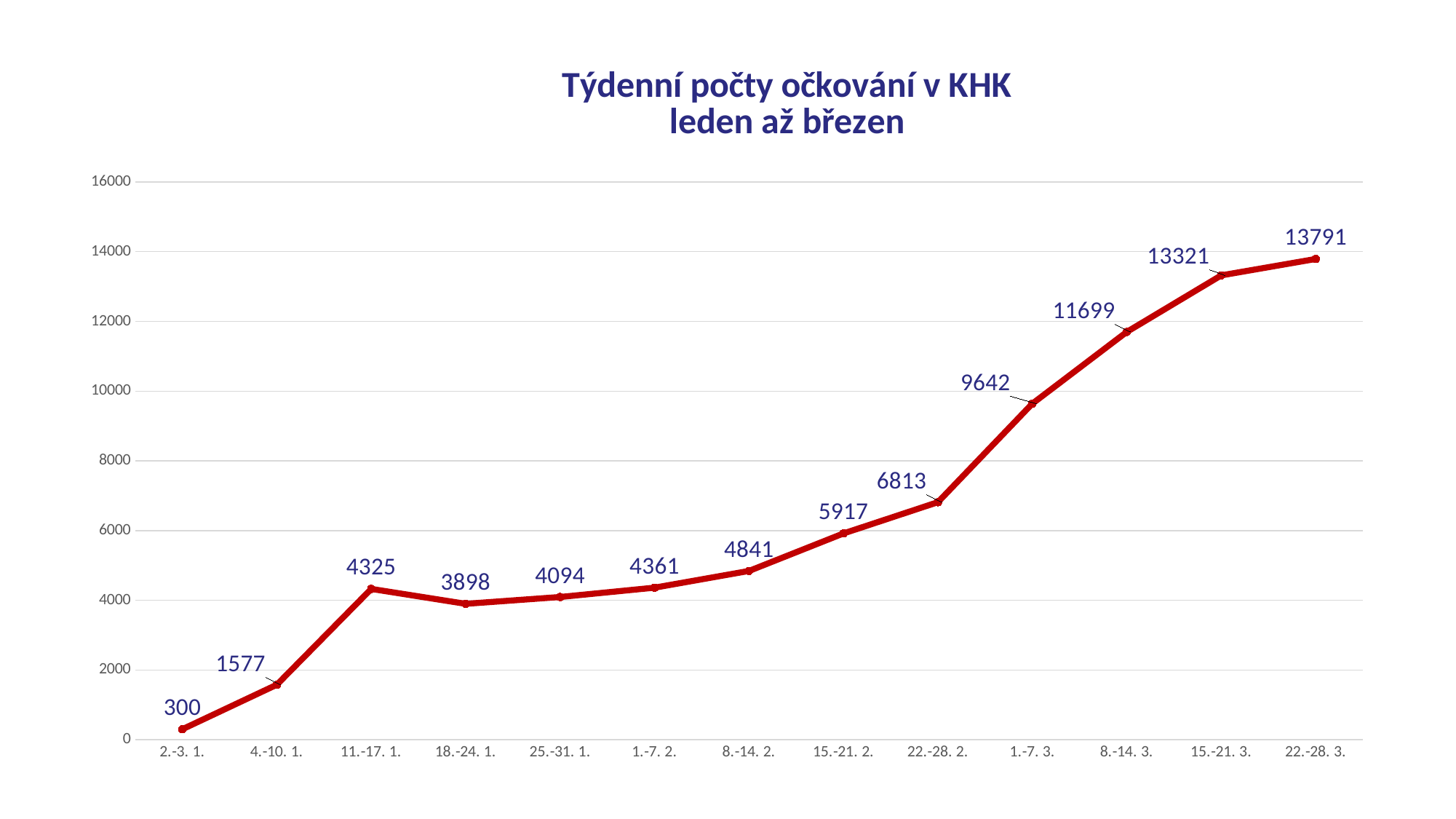
What is the title of the chart? Týdenní počty očkování v KHK leden až březen Which week has the highest value? 22.-28. 3. Which is larger, the value for 11.-17. 1. or the value for 25.-31. 1.? 11.-17. 1. What is the value for the week 1.-7. 3.? 9642 Which week has the lowest value? 2.-3. 1. How many weeks are plotted on the chart? 13 What kind of chart is shown on the slide? line chart What is the difference between the values for 22.-28. 3. and 15.-21. 3.? 470 What is the value for the week 18.-24. 1.? 3898 What is the value for the week 22.-28. 3.? 13791 What is the difference between the values for 11.-17. 1. and 18.-24. 1.? 427 Is the value for 8.-14. 3. greater or less than 12000? less